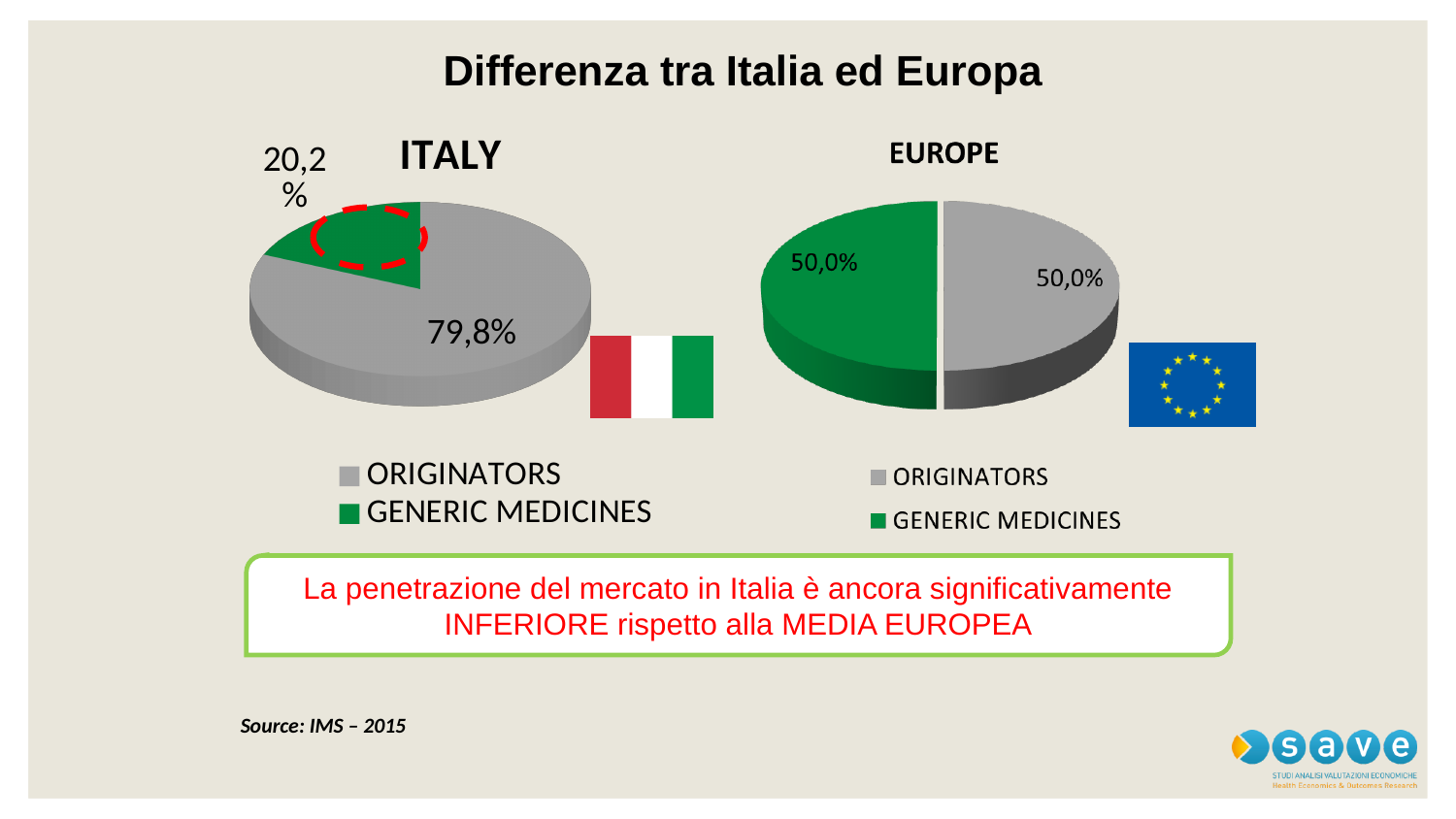
How many categories does the EUROPE pie chart show? 2 In the ITALY pie chart, which category has the largest slice? ORIGINATORS Which is larger: the GENERIC MEDICINES share in the ITALY chart or in the EUROPE chart? EUROPE In the ITALY pie chart, what share do ORIGINATORS have? 79,8% In the ITALY pie chart, what share do GENERIC MEDICINES have? 20,2% In the ITALY pie chart, what is the difference in percentage points between ORIGINATORS and GENERIC MEDICINES? 59,6 What type of chart is the ITALY chart? Pie chart In the EUROPE pie chart, what share do ORIGINATORS have? 50,0% How many entries does the legend of the ITALY chart list? 2 In the EUROPE pie chart, what colour is the GENERIC MEDICINES slice? Green In the EUROPE pie chart, what share do GENERIC MEDICINES have? 50,0% In the ITALY pie chart, which category has the smallest slice? GENERIC MEDICINES